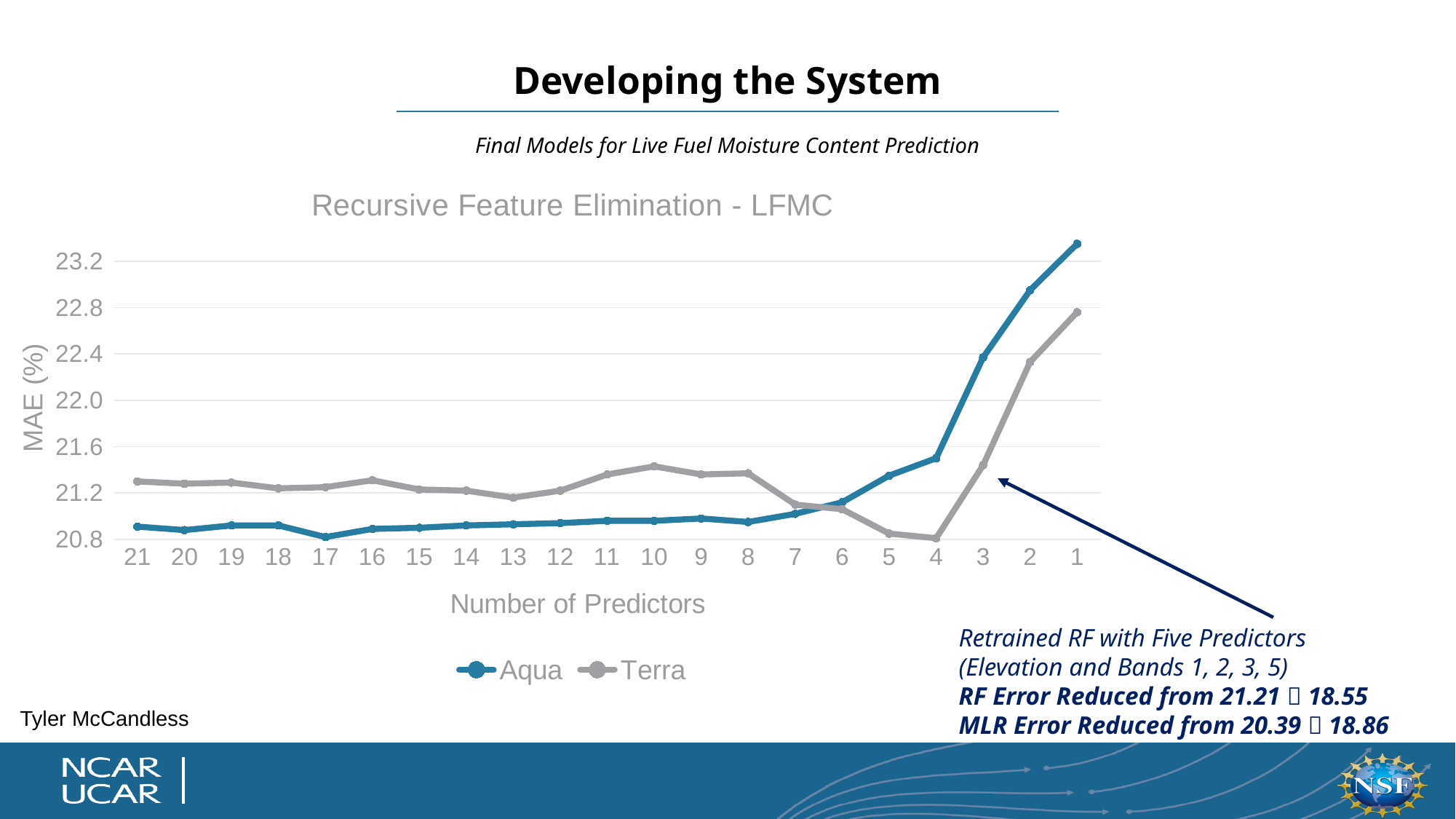
Is the Terra MAE at 3 predictors greater or less than 21.6? less Is the Aqua MAE at 1 predictor greater or less than 23.2? greater What is the title of the chart? Recursive Feature Elimination - LFMC How many series does the legend of the chart list? 2 At 1 predictor, which series has the higher MAE, Aqua or Terra? Aqua What are the two series named in the chart legend? Aqua and Terra What kind of chart is shown on the slide? line chart At which number of predictors does the Aqua series reach its highest MAE? 1 Is the Aqua MAE at 21 predictors greater or less than 21.2? less At 21 predictors, which series has the higher MAE, Aqua or Terra? Terra How many values of Number of Predictors are shown along the x axis? 21 As the number of predictors decreases from 4 to 1, does the Aqua MAE rise or fall? rise